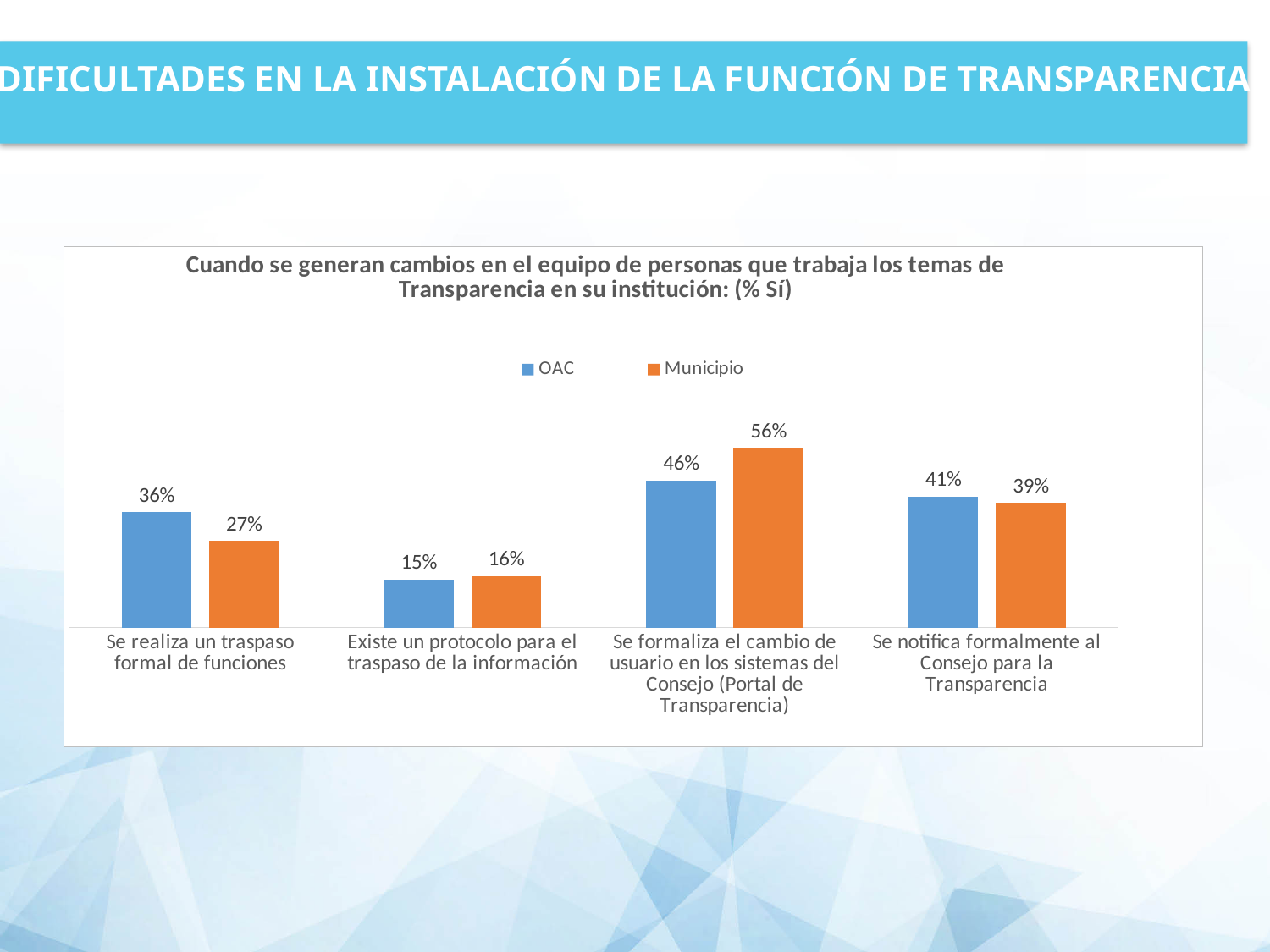
What is the difference between the Municipio and OAC values for "Se formaliza el cambio de usuario en los sistemas del Consejo (Portal de Transparencia)"? 10% What is the Municipio value for "Se formaliza el cambio de usuario en los sistemas del Consejo (Portal de Transparencia)"? 56% Which category has the highest Municipio value? Se formaliza el cambio de usuario en los sistemas del Consejo (Portal de Transparencia) What is the difference between the OAC and Municipio values for "Se realiza un traspaso formal de funciones"? 9% How many series does the legend list? 2 What is the OAC value for "Se notifica formalmente al Consejo para la Transparencia"? 41% What is the OAC value for "Se realiza un traspaso formal de funciones"? 36% What is the Municipio value for "Existe un protocolo para el traspaso de la información"? 16% What kind of chart is shown on the slide? Bar chart For "Se notifica formalmente al Consejo para la Transparencia", which series has the larger value, OAC or Municipio? OAC Which category has the lowest OAC value? Existe un protocolo para el traspaso de la información How many categories are shown on the x axis? 4